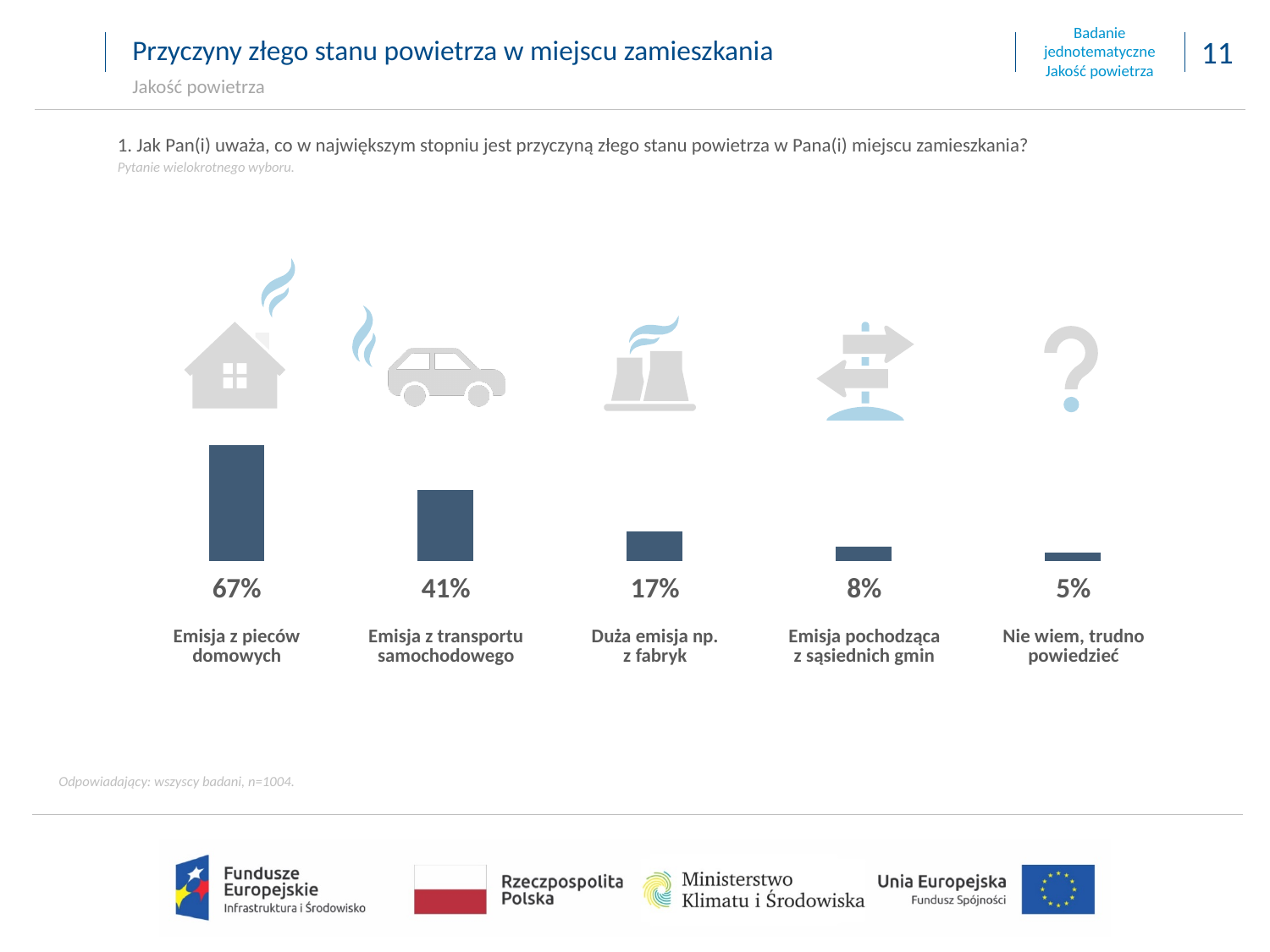
Which is larger: the value for "Duża emisja np. z fabryk" or for "Emisja pochodząca z sąsiednich gmin"? Duża emisja np. z fabryk What is the difference in percentage points between "Emisja z pieców domowych" and "Emisja z transportu samochodowego"? 26 percentage points How many categories are shown on the chart? 5 What percentage of respondents chose "Emisja z pieców domowych" as the cause of poor air quality? 67% What value is shown for "Emisja z transportu samochodowego"? 41% Do the values rise or fall when reading the categories from left to right? Fall What value is shown for "Duża emisja np. z fabryk"? 17% What percentage is shown for "Emisja pochodząca z sąsiednich gmin"? 8% What percentage of respondents answered "Nie wiem, trudno powiedzieć"? 5% What type of chart is shown on the slide? Bar chart Which category has the lowest value on the chart? Nie wiem, trudno powiedzieć Which category has the highest value on the chart? Emisja z pieców domowych